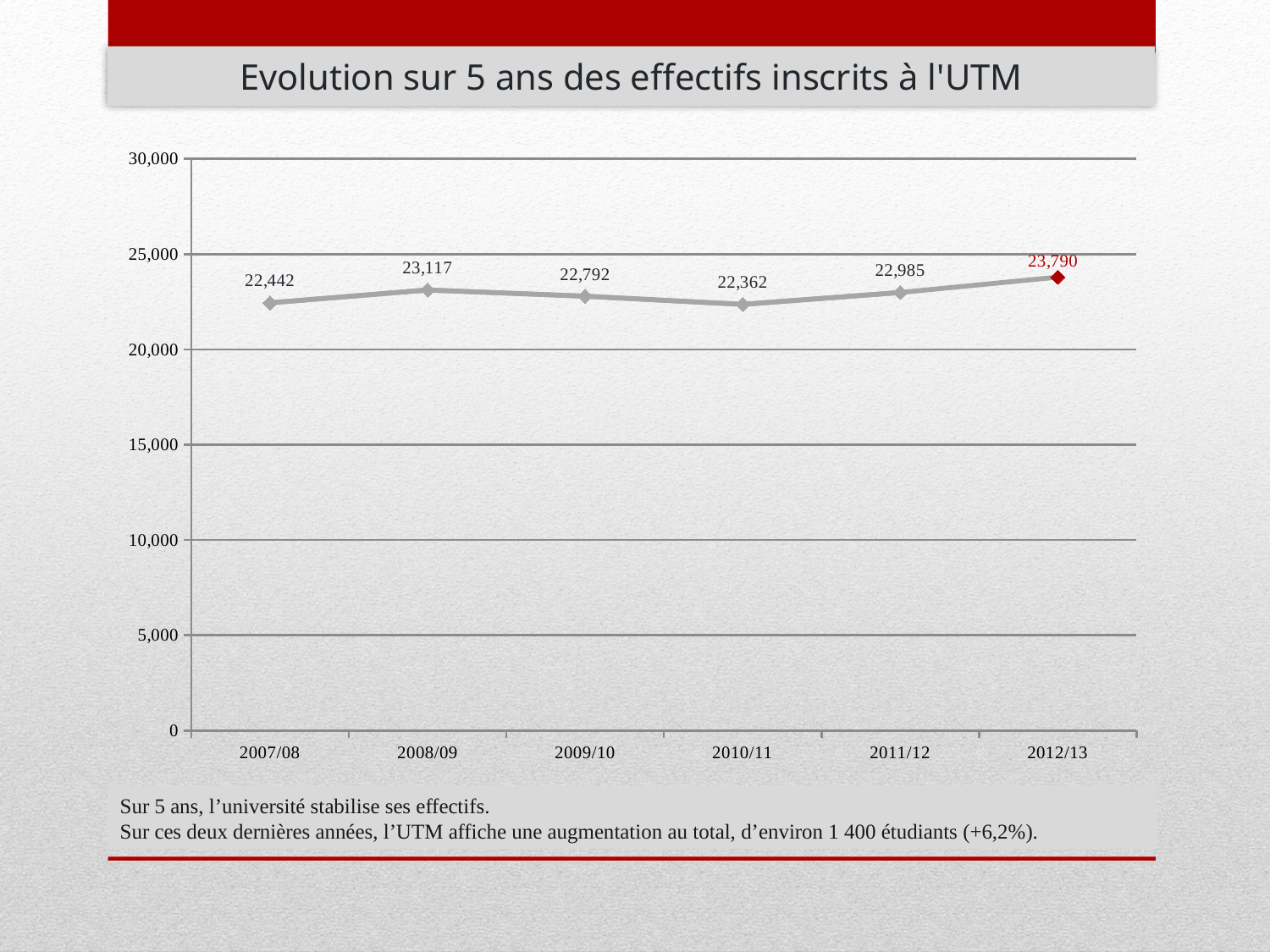
What is the value for 2010/11? 22,362 What is the value for 2012/13? 23,790 What kind of chart is shown on the slide? line chart Which is larger, the value for 2008/09 or the value for 2009/10? 2008/09 How many years are plotted on the chart? 6 What is the title of the chart? Evolution sur 5 ans des effectifs inscrits à l'UTM What is the difference between the values for 2012/13 and 2011/12? 805 Which year has the highest value? 2012/13 What is the difference between the values for 2008/09 and 2009/10? 325 Is the value for 2012/13 greater or less than 25,000? less Which year has the lowest value? 2010/11 What is the value for 2007/08? 22,442